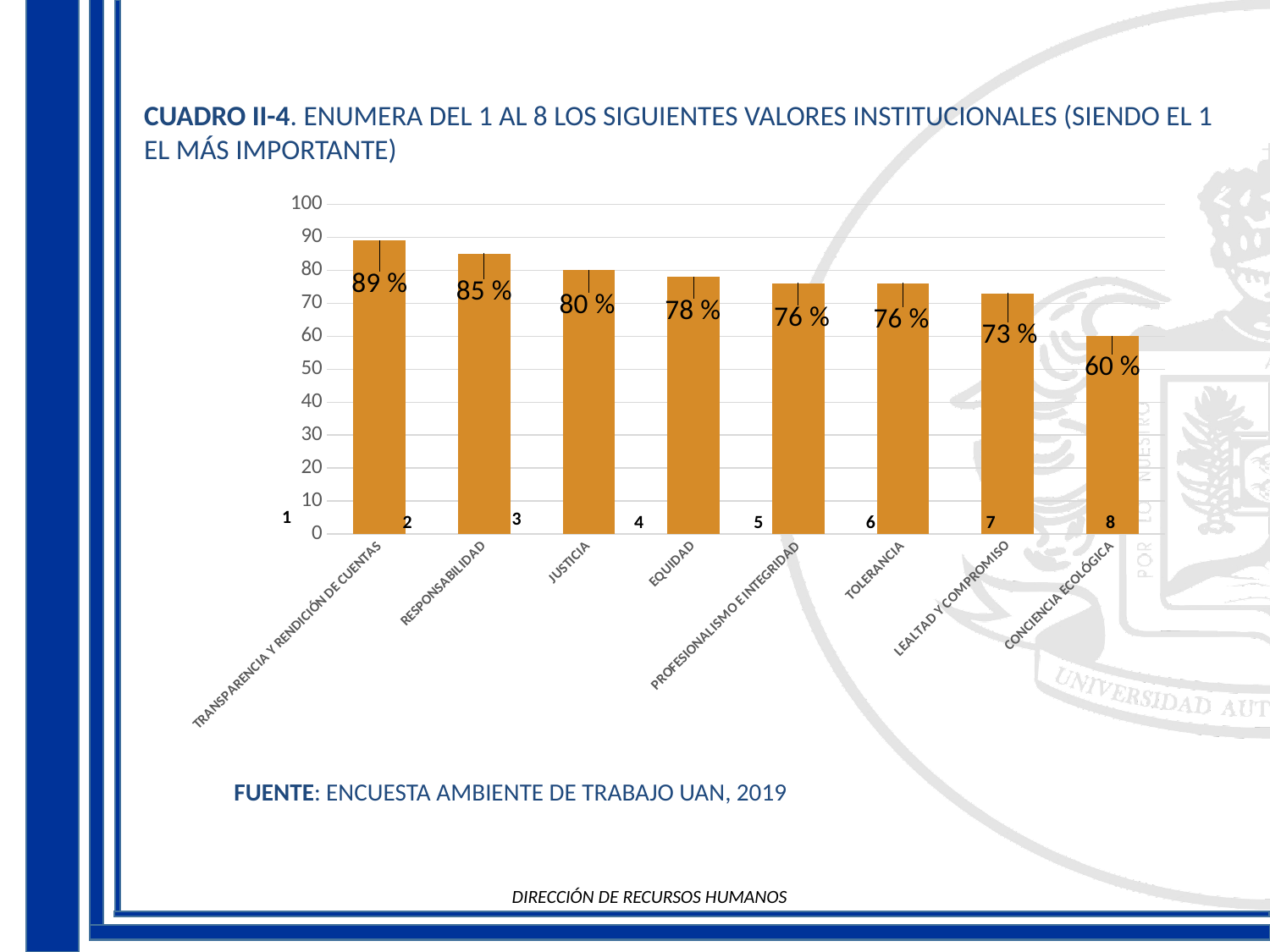
Which category has the highest value? TRANSPARENCIA Y RENDICIÓN DE CUENTAS Which is larger, the value for JUSTICIA or the value for TOLERANCIA? JUSTICIA Do the values rise or fall from left to right along the x axis? fall How many categories are shown in the chart? 8 What is the value for EQUIDAD? 78 % What is the difference between the values for TRANSPARENCIA Y RENDICIÓN DE CUENTAS and CONCIENCIA ECOLÓGICA? 29 % What kind of chart is shown on the slide? bar chart What is the value for CONCIENCIA ECOLÓGICA? 60 % Is the value for PROFESIONALISMO E INTEGRIDAD greater or less than 70? greater What is the value for LEALTAD Y COMPROMISO? 73 % What is the value for RESPONSABILIDAD? 85 % Which category has the lowest value? CONCIENCIA ECOLÓGICA